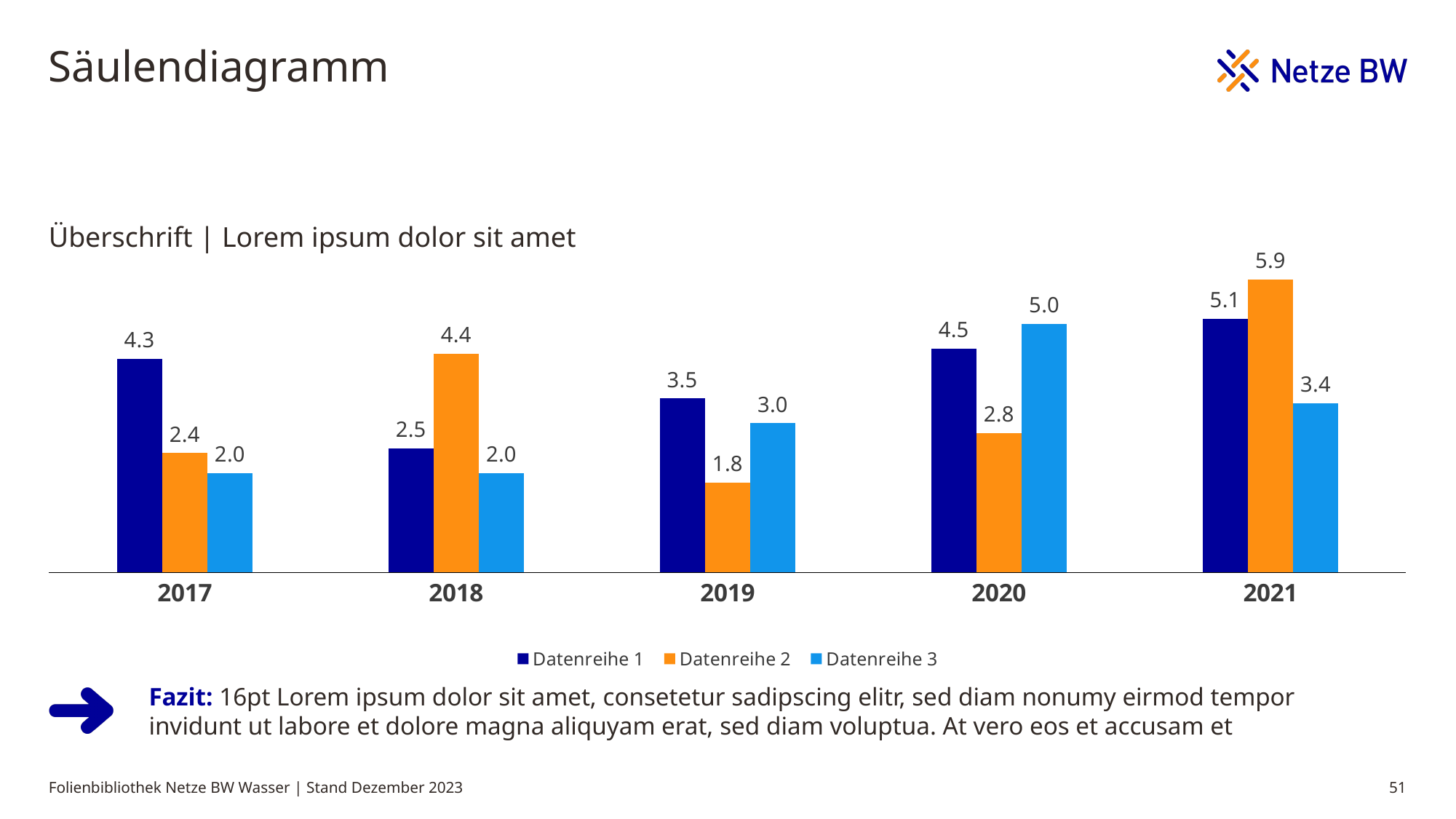
In which year is Datenreihe 2 lowest? 2019 What colour are the bars for Datenreihe 2? Orange How many years are shown on the x axis? 5 What is the value for Datenreihe 3 in 2020? 5.0 Does Datenreihe 3 rise or fall from 2019 to 2020? Rise How many series does the legend list? 3 Which is larger in 2019, Datenreihe 1 or Datenreihe 3? Datenreihe 1 What is the difference between Datenreihe 1 and Datenreihe 3 in 2021? 1.7 What kind of chart is shown on the slide? Bar chart What is the value for Datenreihe 2 in 2018? 4.4 What is the value for Datenreihe 1 in 2017? 4.3 In which year is Datenreihe 2 highest? 2021